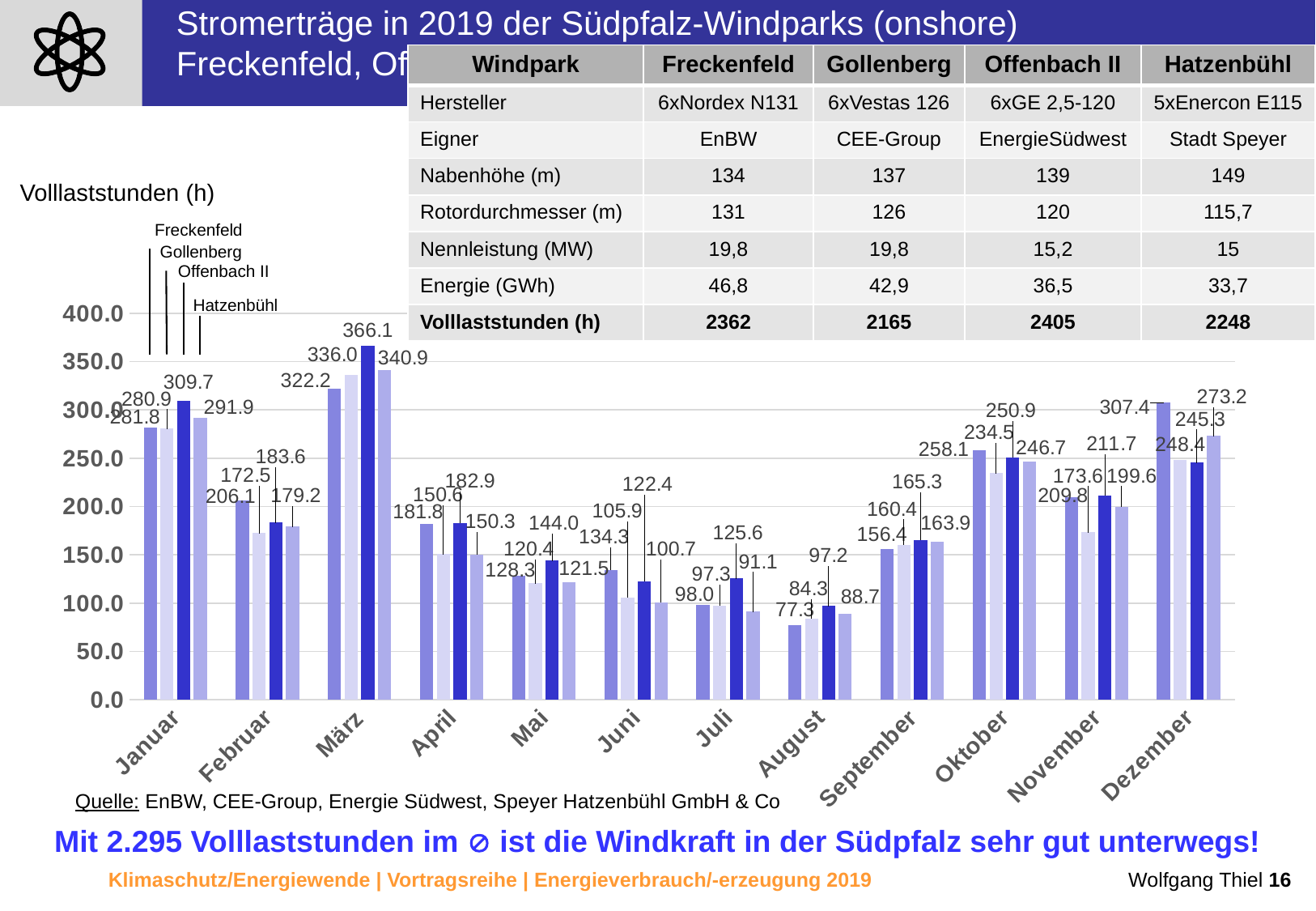
Is the value for Offenbach II in Januar greater or less than 300? greater What is the lowest value shown in the chart, and in which month does it occur? 77.3 in August What is the difference between the Offenbach II value in März (366.1) and the Freckenfeld value in März (322.2)? 43.9 What kind of chart is shown on the slide? bar chart Do the values for Freckenfeld rise or fall from März to August? fall What is the value for Freckenfeld in Februar? 206.1 How many wind parks (series) does the chart legend list? 4 What is the highest value shown in the chart, and in which month does it occur? 366.1 in März Which is larger in Oktober: the value for Freckenfeld or the value for Gollenberg? Freckenfeld What is the value for Hatzenbühl in Dezember? 273.2 What is the value for Offenbach II in Juli? 125.6 How many months are shown along the x axis of the chart? 12